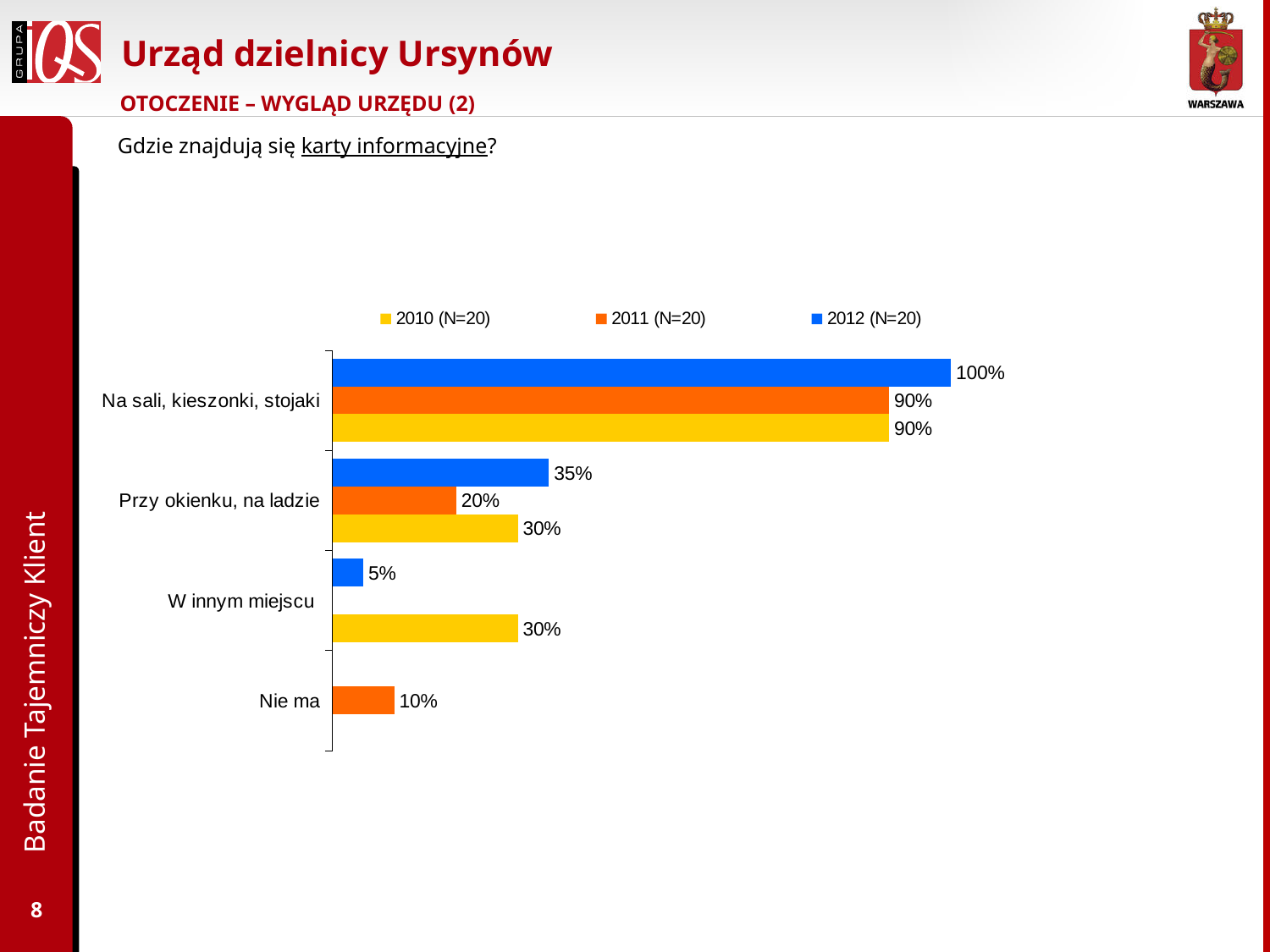
What kind of chart is shown on the slide? bar chart What is the value for 'W innym miejscu' in the 2010 (N=20) series? 30% Which category has the lowest value in the 2012 (N=20) series? W innym miejscu What is the value for 'Na sali, kieszonki, stojaki' in the 2012 (N=20) series? 100% Which is larger for 'Przy okienku, na ladzie': the 2010 (N=20) value or the 2012 (N=20) value? 2012 (N=20) Which category has the highest value in the 2012 (N=20) series? Na sali, kieszonki, stojaki How many categories are shown on the chart? 4 Which legend entry is shown in blue? 2012 (N=20) What is the value for 'Nie ma' in the 2011 (N=20) series? 10% What is the value for 'Przy okienku, na ladzie' in the 2011 (N=20) series? 20% How many series does the legend list? 3 What is the difference between the 2012 (N=20) and 2011 (N=20) values for 'Przy okienku, na ladzie'? 15%